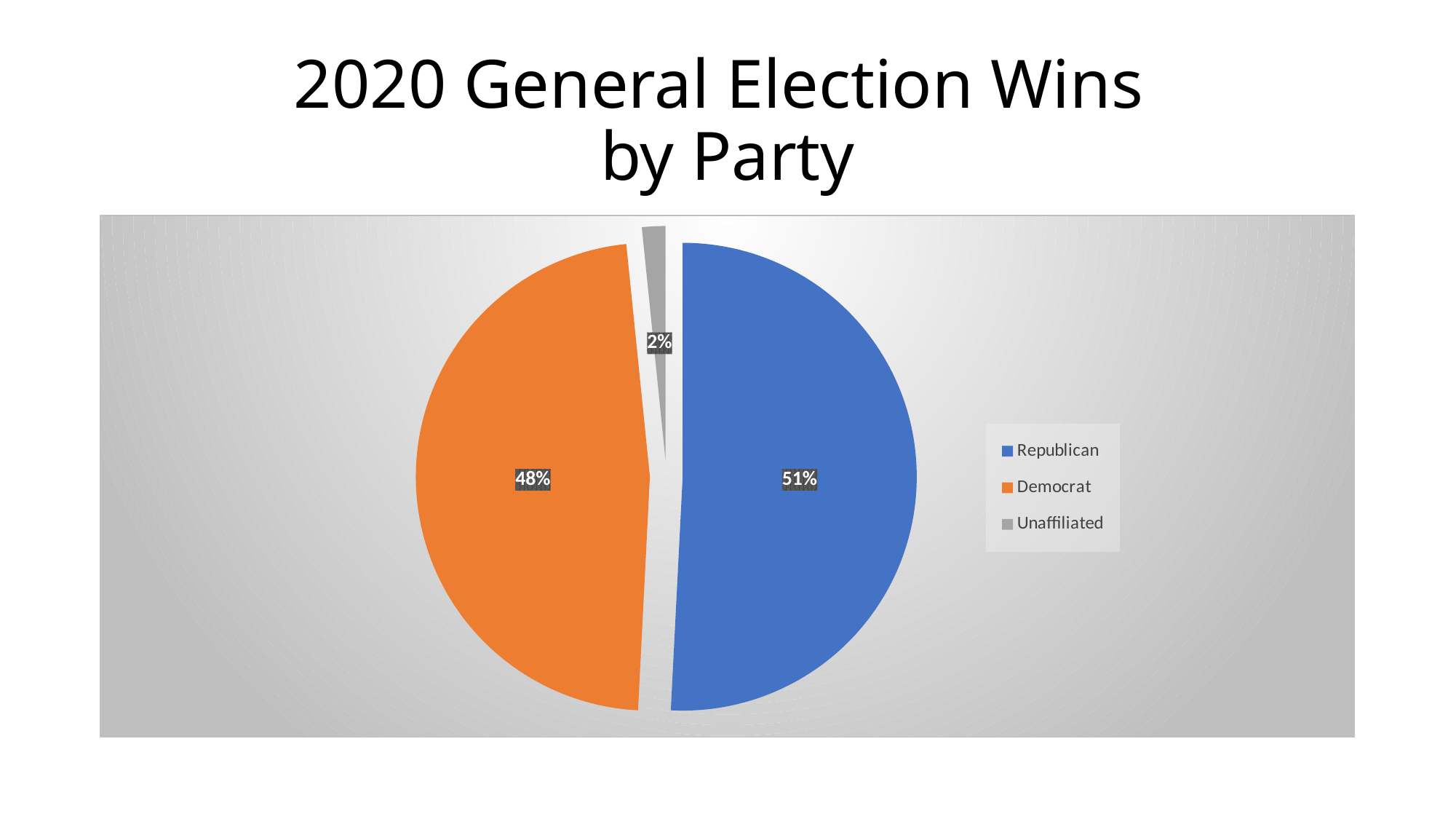
What share of the pie does Democrat have? 48% How many slices does the pie chart have? 3 Which party has the smallest slice of the pie? Unaffiliated Which slice is larger, Republican or Democrat? Republican What is the difference in percentage points between the Republican and Democrat slices? 3 Which party has the largest slice of the pie? Republican What is the difference in percentage points between the Democrat and Unaffiliated slices? 46 What share of the pie does Unaffiliated have? 2% What share of the pie does Republican have? 51% What is the title of the slide? 2020 General Election Wins by Party What kind of chart is shown on the slide? Pie chart What colour is the Democrat slice? Orange